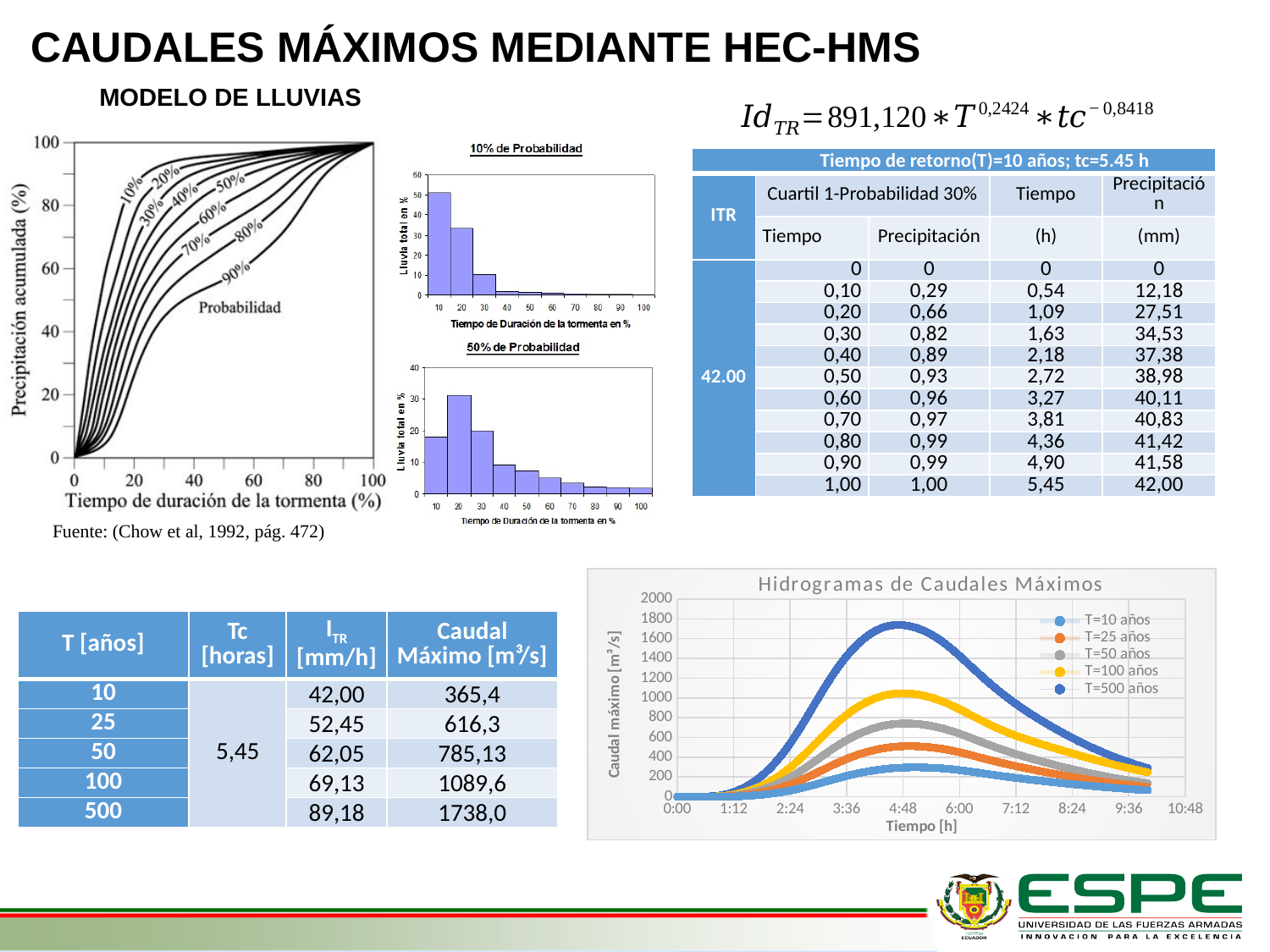
In the 'Hidrogramas de Caudales Máximos' chart, is the peak of the T=500 años series greater or less than 1600? greater In the 'Hidrogramas de Caudales Máximos' chart, which series has a higher peak, T=100 años or T=50 años? T=100 años In the '10% de Probabilidad' chart, is the value of the tallest bar greater or less than 40? greater How many series does the legend of the 'Hidrogramas de Caudales Máximos' chart list? 5 In the 'Hidrogramas de Caudales Máximos' chart, which series has the lowest peak flow? T=10 años What kind of chart is the 'Hidrogramas de Caudales Máximos' chart? line chart In the '50% de Probabilidad' chart, which duration bin has the tallest bar? 20 What kind of chart is the '10% de Probabilidad' chart? bar chart In the 'Hidrogramas de Caudales Máximos' chart, which series reaches the highest peak flow? T=500 años In the 'Hidrogramas de Caudales Máximos' chart, is the peak of the T=100 años series greater or less than 1000? greater What is the y-axis title of the 'Hidrogramas de Caudales Máximos' chart? Caudal máximo [m³/s]